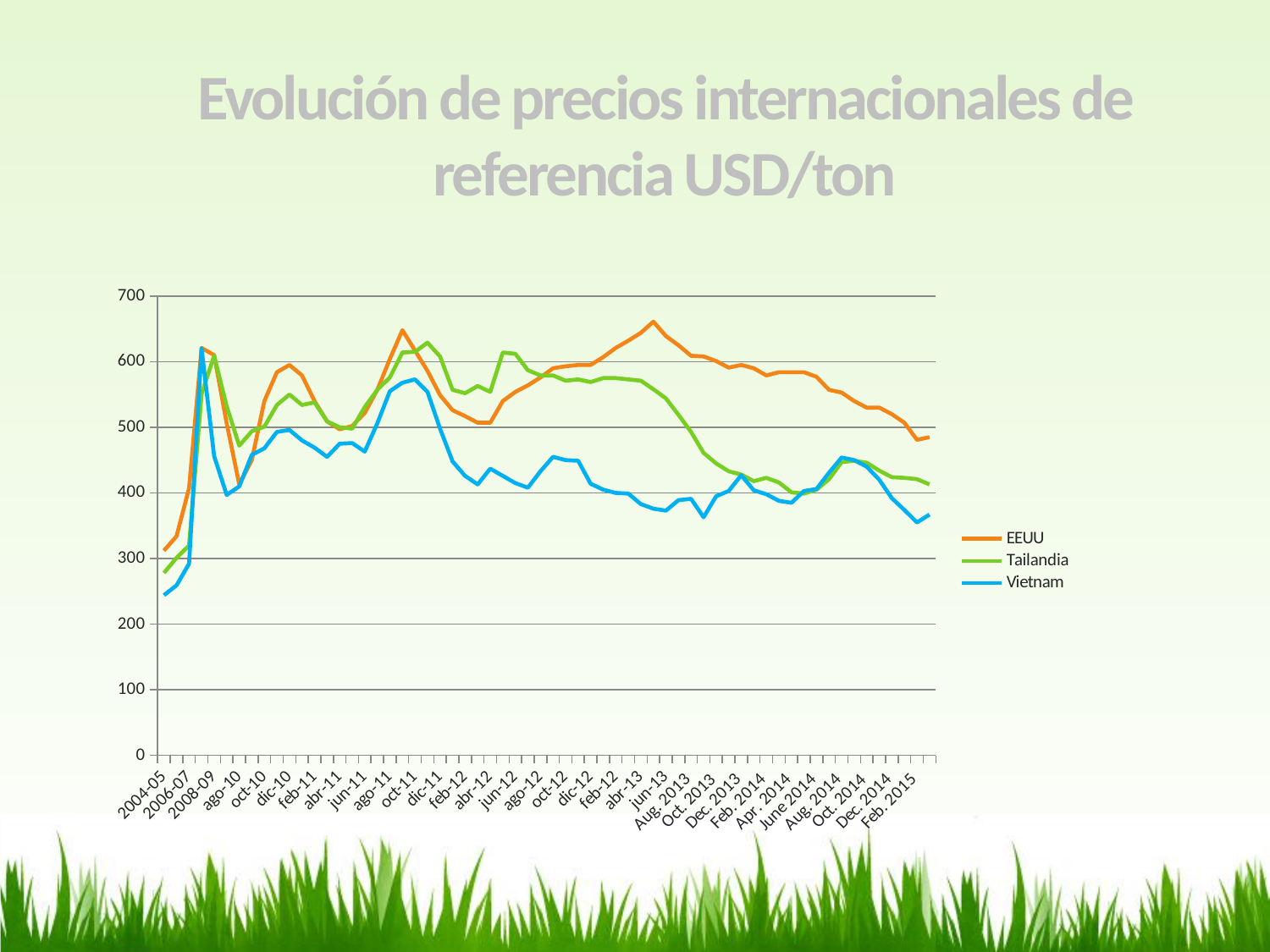
Is the value for Vietnam at Feb. 2015 greater or less than 400? less Which series has the lowest value at Feb. 2015? Vietnam How many series does the legend list? 3 Is the value for EEUU at Feb. 2015 greater or less than 500? less Is the value for EEUU at jun-13 greater or less than 600? greater At jun-13, which series has the higher value, EEUU or Vietnam? EEUU What kind of chart is shown on the slide? line chart Does the EEUU series rise or fall from jun-13 to Feb. 2015? fall Which colour is used for the Vietnam series? blue What is the title of the chart? Evolución de precios internacionales de referencia USD/ton